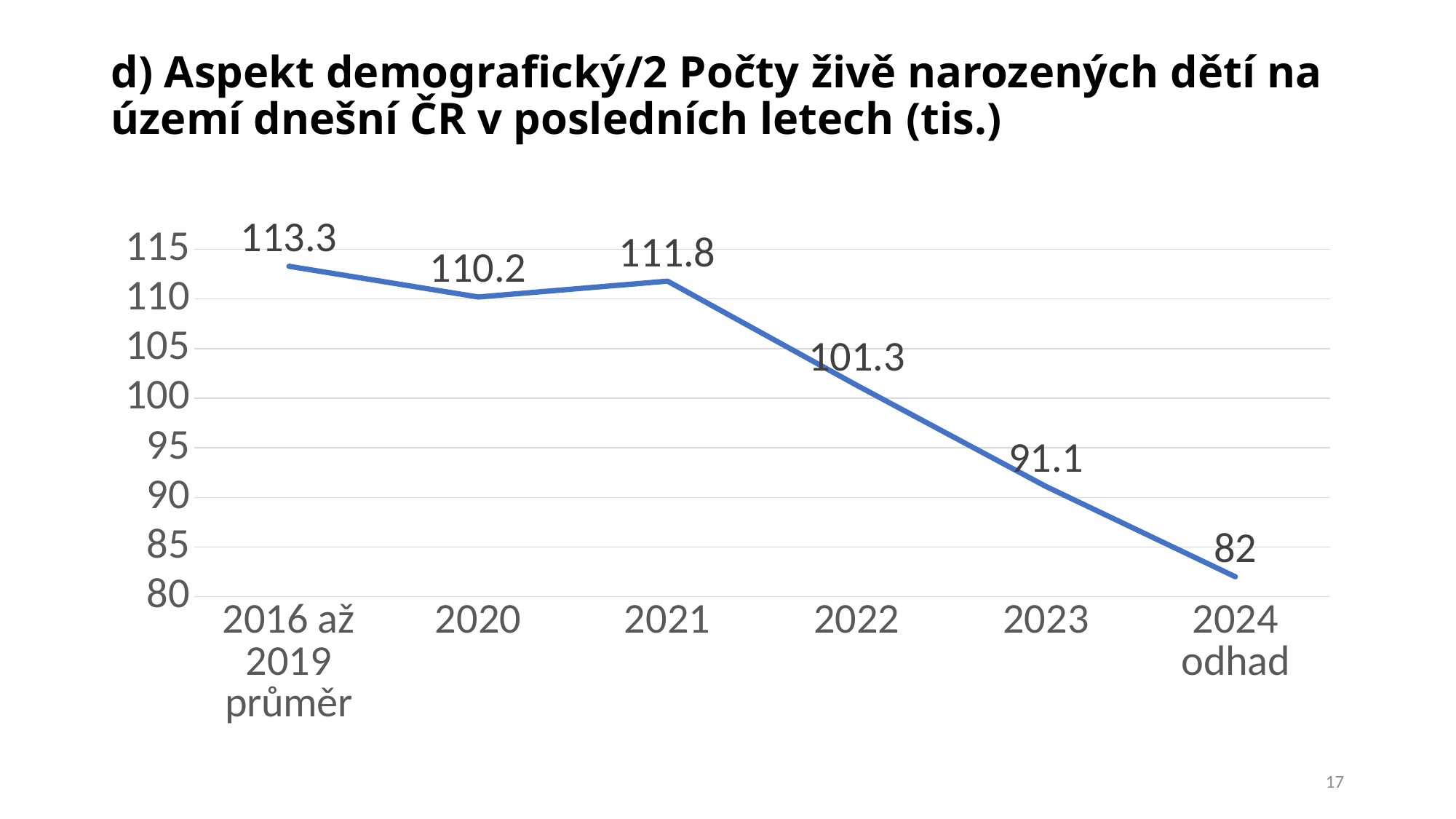
What is the value for 2016 až 2019 průměr? 113.3 Which is larger, the value for 2020 or the value for 2021? 2021 Do the values rise or fall from 2021 to 2024 odhad? fall What is the value for 2021? 111.8 Is the value for 2022 greater or less than 100? greater What is the value for 2024 odhad? 82 What is the difference between the values for 2016 až 2019 průměr and 2024 odhad? 31.3 Which category has the highest value? 2016 až 2019 průměr Which category has the lowest value? 2024 odhad What is the difference between the values for 2022 and 2023? 10.2 How many categories are shown on the x axis? 6 What kind of chart is this? line chart